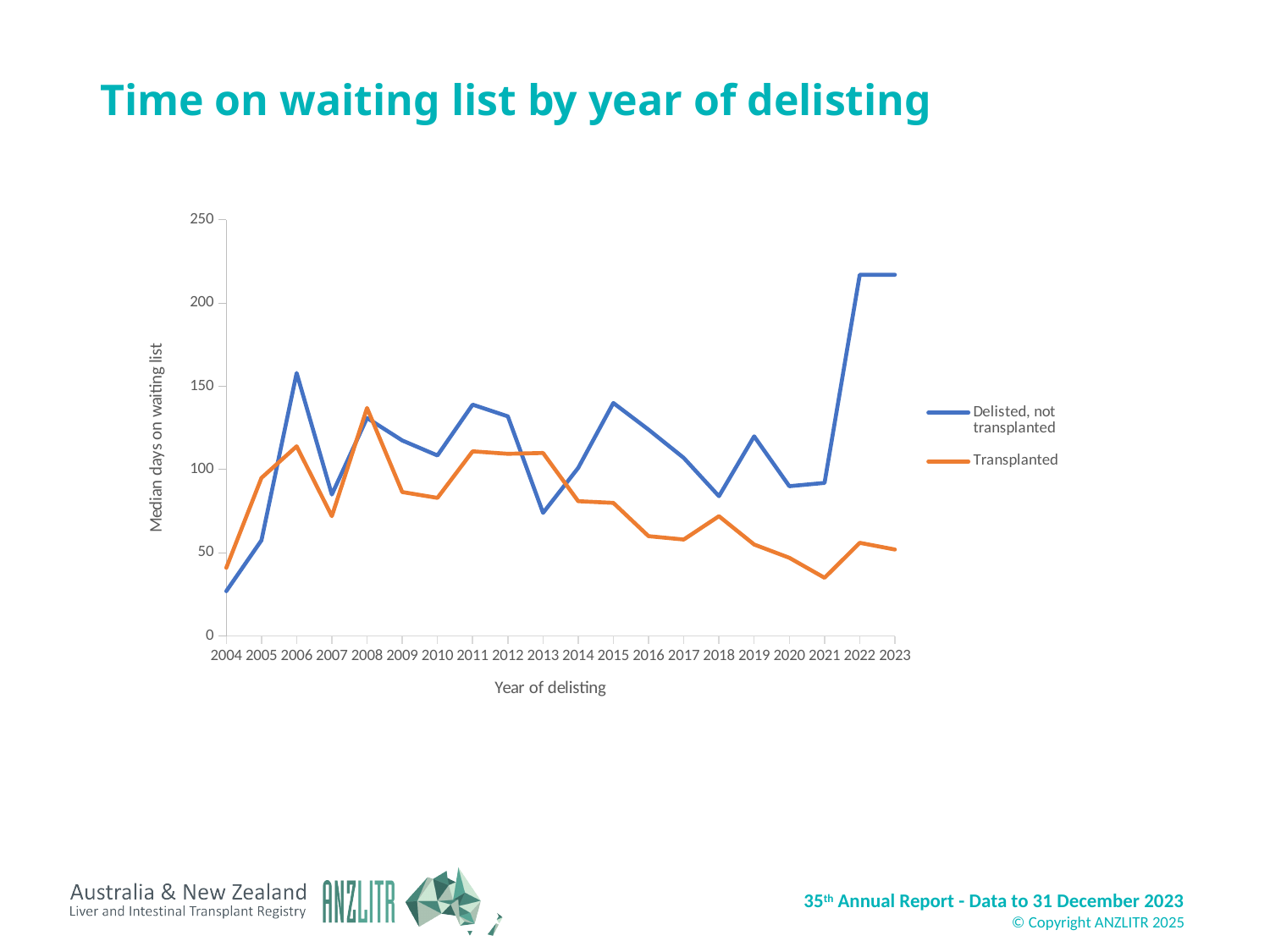
Is the value for Transplanted in 2021 greater or less than 50? less Is the value for Transplanted in 2008 greater or less than 100? greater In which year is the Delisted, not transplanted series at its lowest? 2004 What is the label of the y axis? Median days on waiting list Is the value for Delisted, not transplanted in 2022 greater or less than 200? greater How many series does the legend list? 2 What kind of chart is shown on the slide? Line chart How many years are plotted along the x axis? 20 What are the two series named in the legend? Delisted, not transplanted; Transplanted In 2013, which series has the higher value: Delisted, not transplanted or Transplanted? Transplanted In which year is the Transplanted series at its highest? 2008